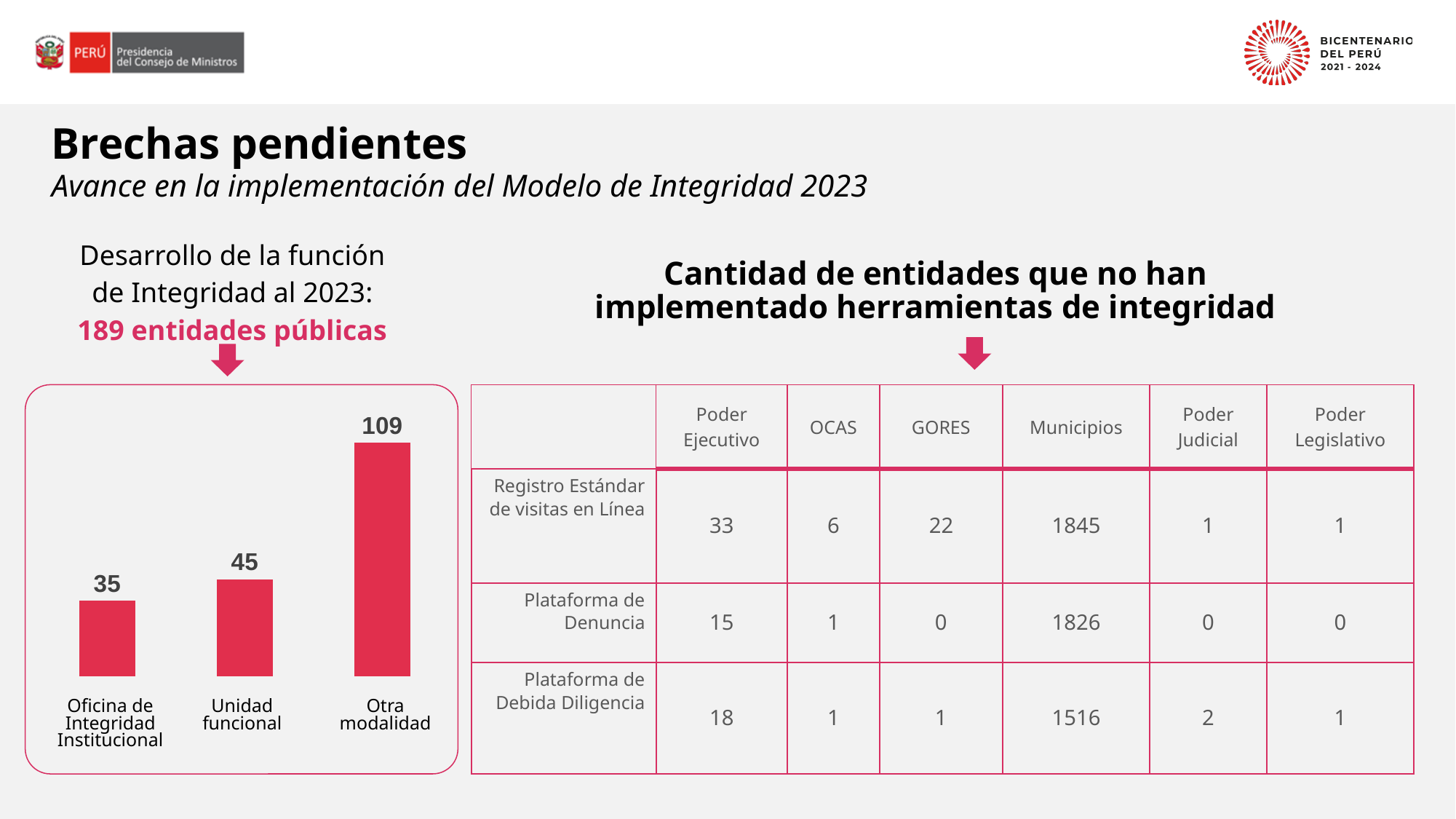
In the bar chart, what is the difference between the values for Unidad funcional and Oficina de Integridad Institucional? 10 In the bar chart, which is larger: the value for Unidad funcional or the value for Oficina de Integridad Institucional? Unidad funcional What type of chart is shown on the left of the slide? bar chart Which category has the lowest value in the bar chart? Oficina de Integridad Institucional In the bar chart, what is the value for Otra modalidad? 109 In the bar chart, what is the difference between the values for Otra modalidad and Unidad funcional? 64 How many categories are shown in the bar chart? 3 Do the values in the bar chart rise or fall from left to right? rise Which category has the highest value in the bar chart? Otra modalidad In the bar chart, what is the value for Unidad funcional? 45 In the bar chart, what is the value for Oficina de Integridad Institucional? 35 What is the total of the three values shown in the bar chart? 189